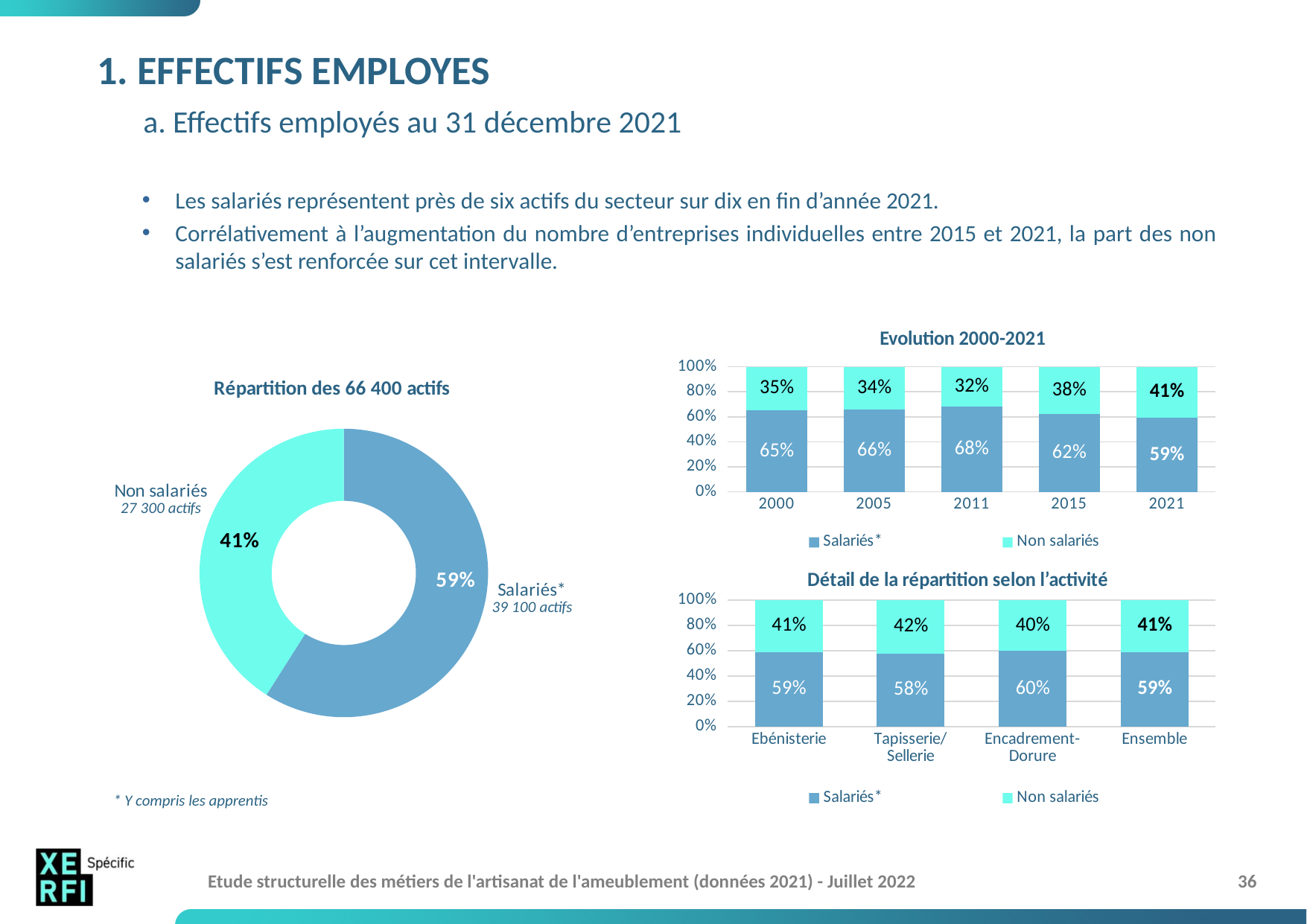
In the 'Détail de la répartition selon l'activité' chart, which activity has the highest Salariés* share? Encadrement-Dorure In the 'Répartition des 66 400 actifs' chart, how many actifs are Non salariés? 27 300 actifs In the 'Détail de la répartition selon l'activité' chart, what is the Salariés* value for Tapisserie/Sellerie? 58% In the 'Evolution 2000-2021' chart, how many years are shown on the x axis? 5 In the 'Répartition des 66 400 actifs' chart, what share of the total is Salariés*? 59% In the 'Evolution 2000-2021' chart, which year has the lowest Non salariés share? 2011 What kind of chart is 'Répartition des 66 400 actifs'? Doughnut chart How many series does the legend of the 'Détail de la répartition selon l'activité' chart list? 2 In the 'Evolution 2000-2021' chart, which year has the highest Salariés* share? 2011 In the 'Evolution 2000-2021' chart, what is the value for Salariés* in 2011? 68% In the 'Evolution 2000-2021' chart, what is the difference between the Non salariés share in 2021 and in 2000? 6 percentage points In the 'Evolution 2000-2021' chart, what is the value for Non salariés in 2015? 38%